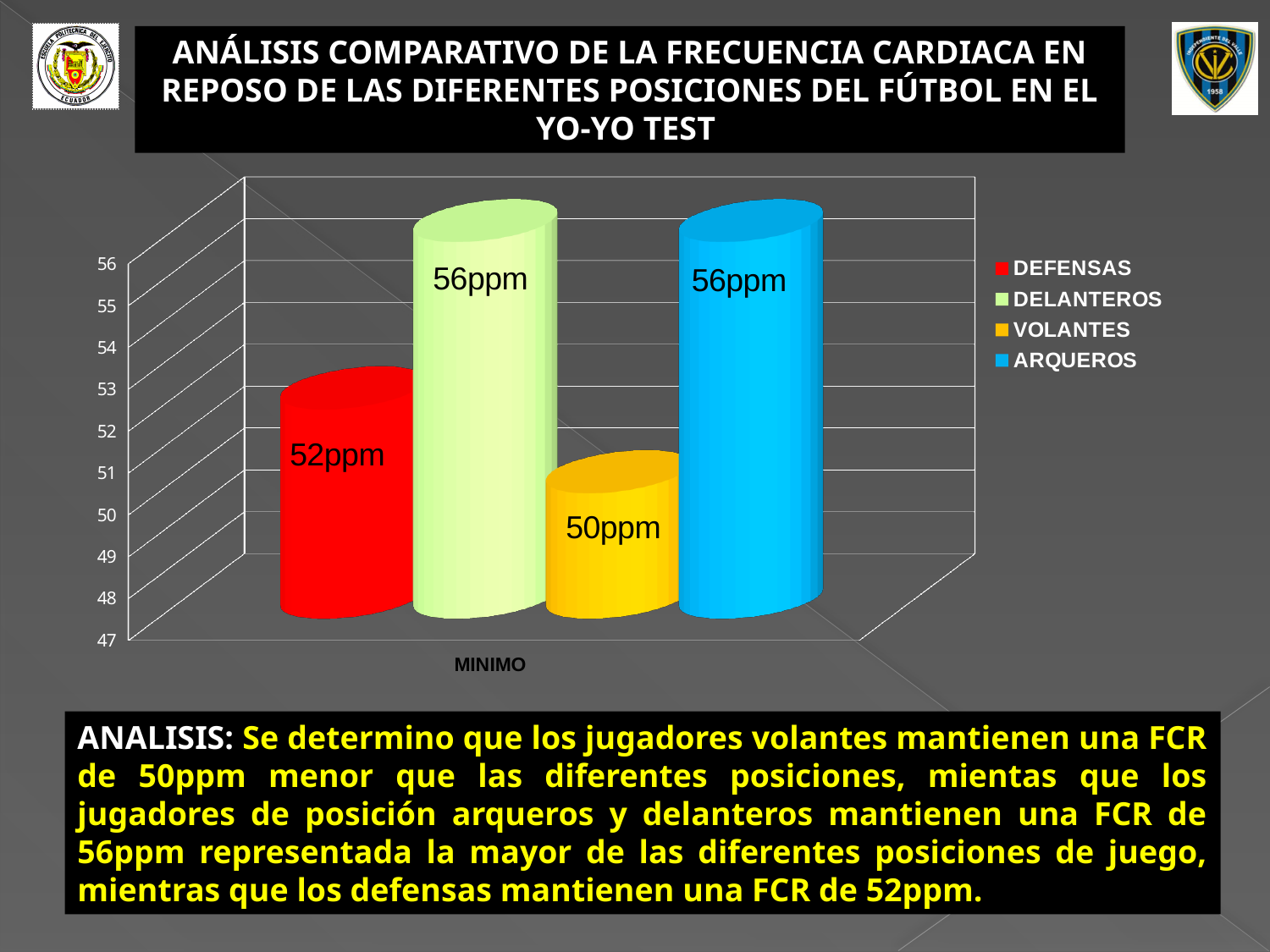
What is the value for ARQUEROS in the chart? 56ppm What colour is the bar for VOLANTES in the chart? Yellow What is the value for VOLANTES in the chart? 50ppm What is the category label shown on the x axis of the chart? MINIMO Which series has the lowest value in the chart? VOLANTES What is the value for DEFENSAS in the chart? 52ppm What kind of chart is shown on the slide? Bar chart How many series does the legend list? 4 What is the value for DELANTEROS in the chart? 56ppm What is the difference between the values for DEFENSAS and VOLANTES? 2ppm Which is larger, the value for DEFENSAS or the value for ARQUEROS? ARQUEROS What is the difference between the values for DELANTEROS and VOLANTES? 6ppm